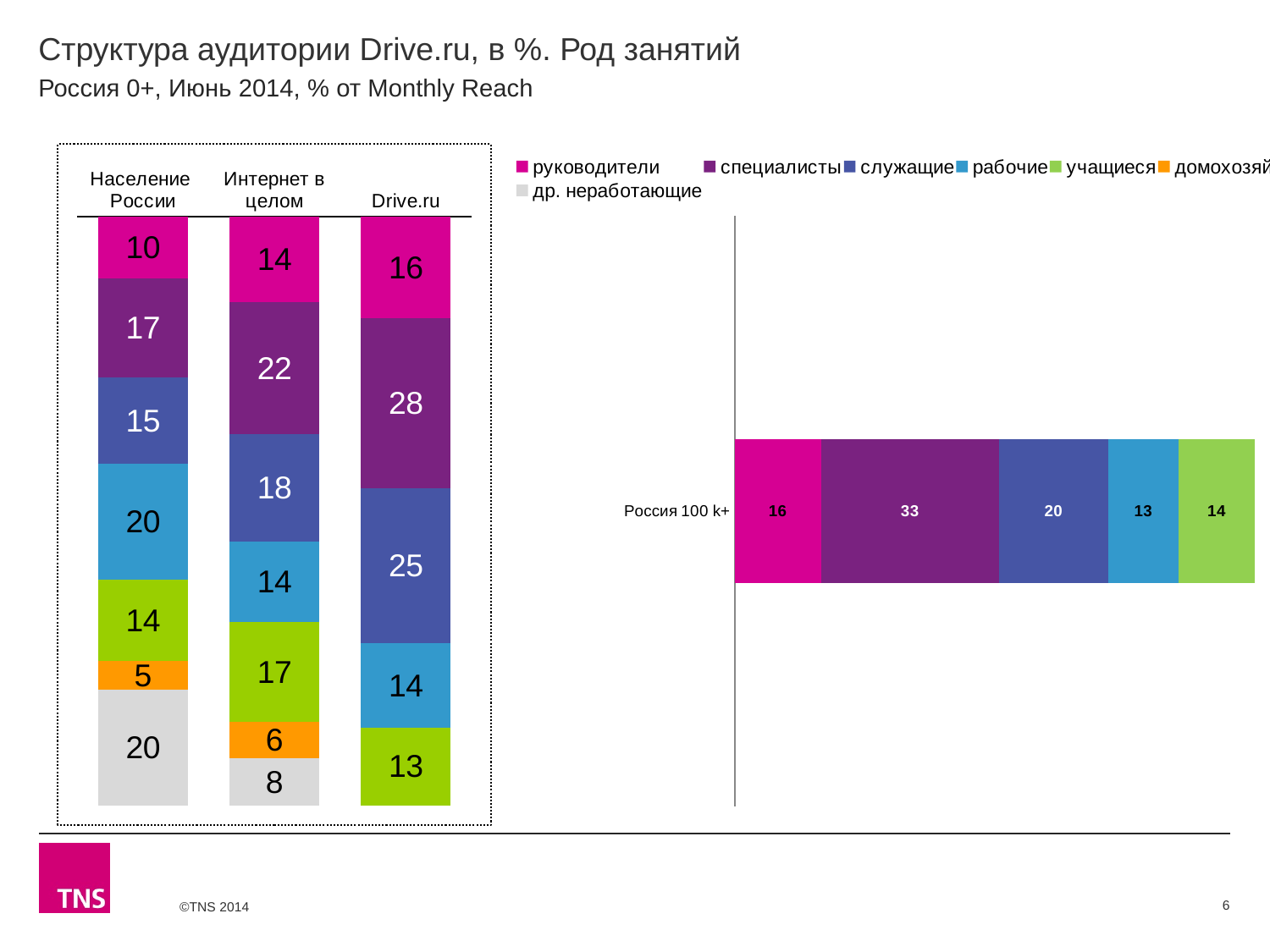
In the right chart (Россия 100 k+), how many segments make up the bar? 5 What is the total of the Drive.ru stacked column in the left chart? 96 In the left chart, what is the difference between the руководители values for Drive.ru and Население России? 6 In the right chart (Россия 100 k+), which occupation group has the largest value? специалисты In the left chart, which is larger: the учащиеся value for Интернет в целом or for Drive.ru? Интернет в целом In the right chart (Россия 100 k+), which occupation group has the smallest value? рабочие In the left chart, what is the value for служащие in the Интернет в целом column? 18 What type of chart is the right chart (Россия 100 k+)? Stacked bar chart In the left chart, how many columns (audience groups) are shown? 3 In the left chart, what is the value for специалисты in the Drive.ru column? 28 In the right chart (Россия 100 k+), what is the value for специалисты? 33 In the left chart, what is the value for рабочие in the Население России column? 20